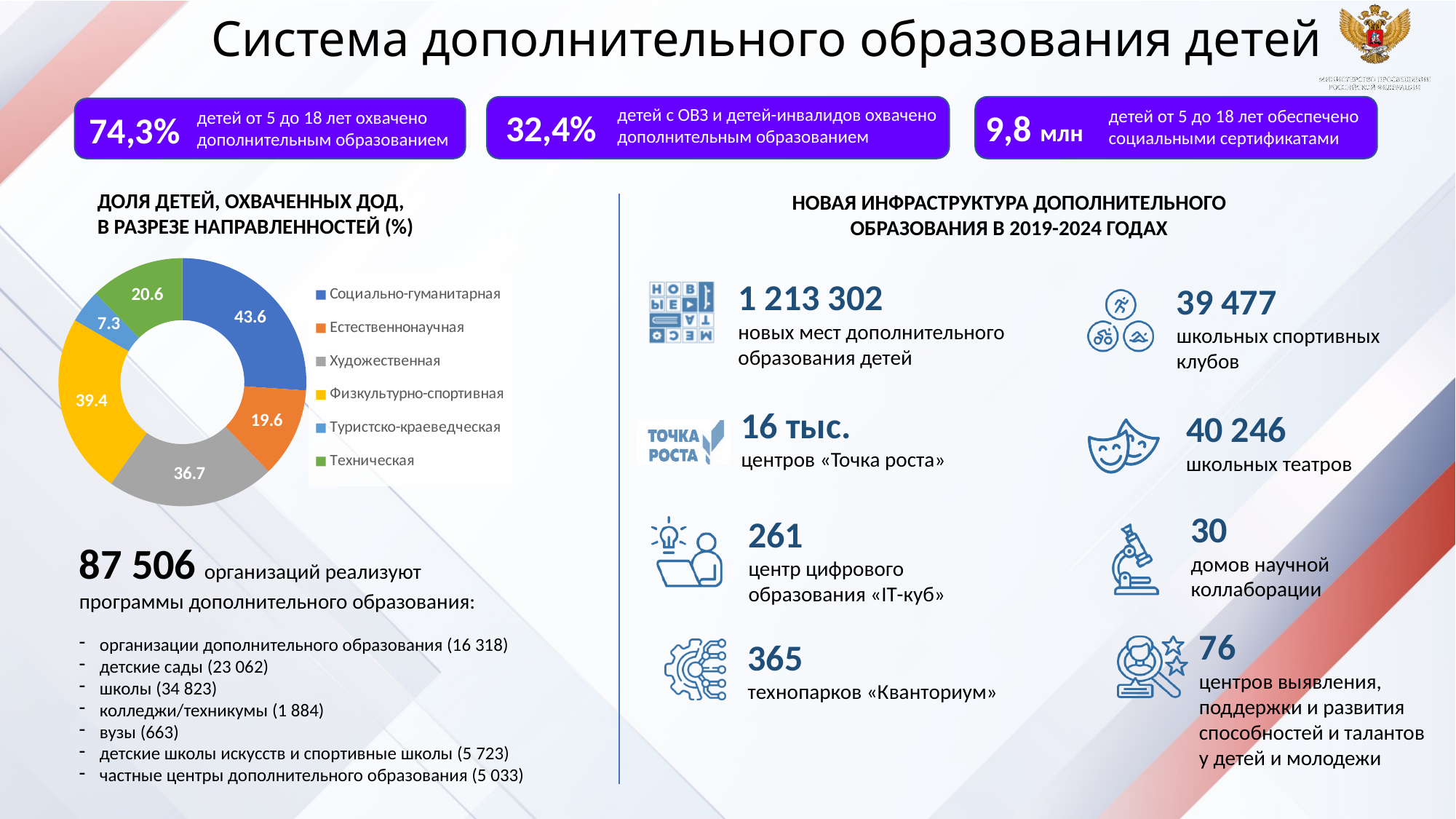
What is the value for «Художественная» in the doughnut chart? 36.7 What is the value for «Туристско-краеведческая» in the doughnut chart? 7.3 Which is larger in the doughnut chart: «Техническая» or «Естественнонаучная»? Техническая Which category has the lowest value in the doughnut chart? Туристско-краеведческая What is the value for «Физкультурно-спортивная» in the doughnut chart? 39.4 What type of chart is shown under the title «ДОЛЯ ДЕТЕЙ, ОХВАЧЕННЫХ ДОД, В РАЗРЕЗЕ НАПРАВЛЕННОСТЕЙ (%)»? Doughnut chart What colour is the «Физкультурно-спортивная» segment in the doughnut chart? Yellow What is the difference between the values for «Социально-гуманитарная» and «Естественнонаучная» in the doughnut chart? 24 How many categories does the doughnut chart show? 6 Which category has the highest value in the doughnut chart? Социально-гуманитарная What is the value for «Социально-гуманитарная» in the doughnut chart? 43.6 What is the value for «Естественнонаучная» in the doughnut chart? 19.6